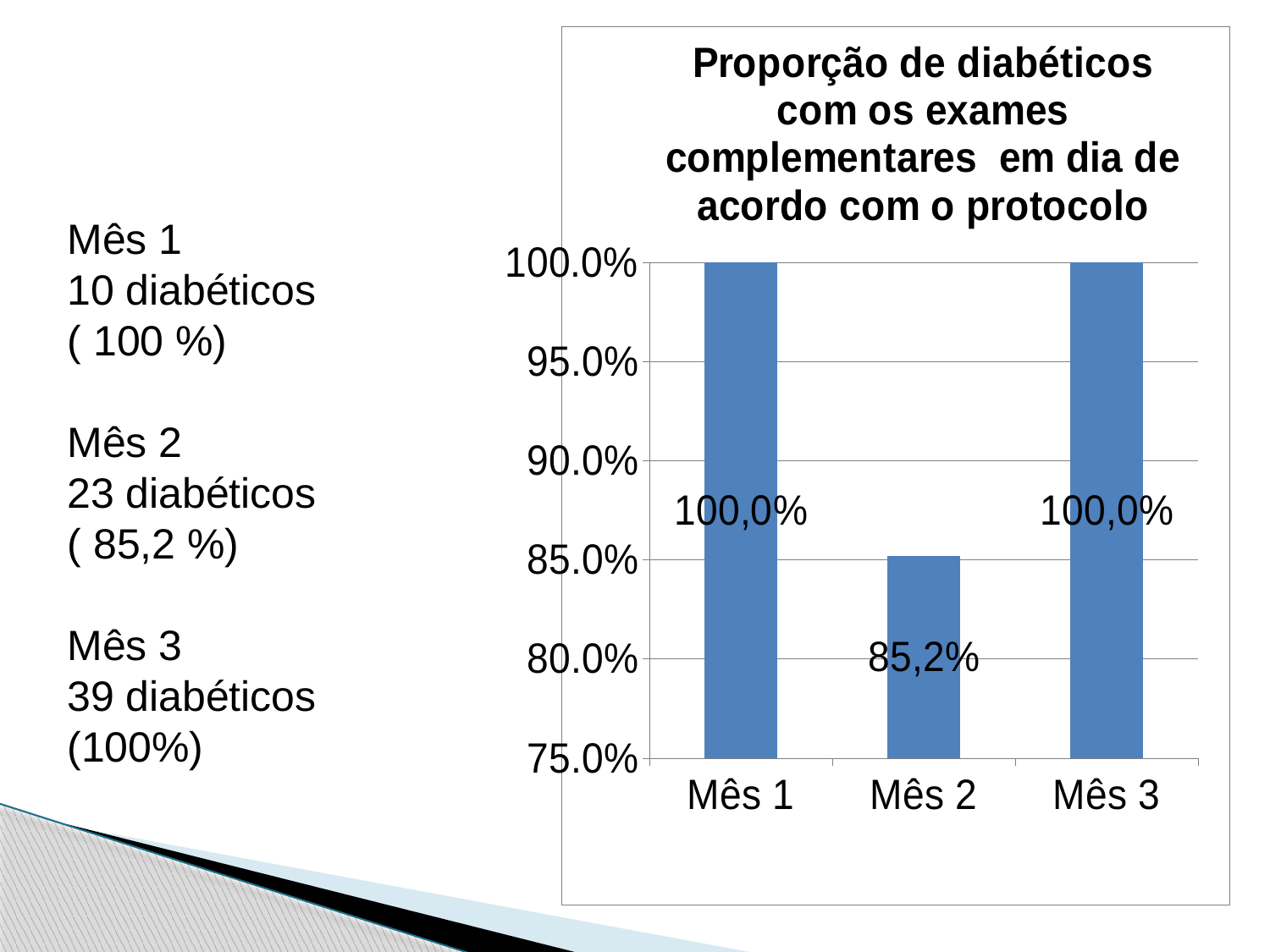
Which is larger, the value for Mês 2 or the value for Mês 3? Mês 3 Is the value for Mês 2 greater or less than 90.0%? less What is the value for Mês 1? 100,0% What is the value for Mês 3? 100,0% Is the value for Mês 2 greater or less than 80.0%? greater How many categories are shown on the x axis? 3 What kind of chart is shown on the slide? bar chart Do the values rise or fall from Mês 2 to Mês 3? rise What is the title of the chart? Proporção de diabéticos com os exames complementares em dia de acordo com o protocolo What is the difference between the values for Mês 1 and Mês 2? 14,8% Which month has the lowest value? Mês 2 What is the value for Mês 2? 85,2%